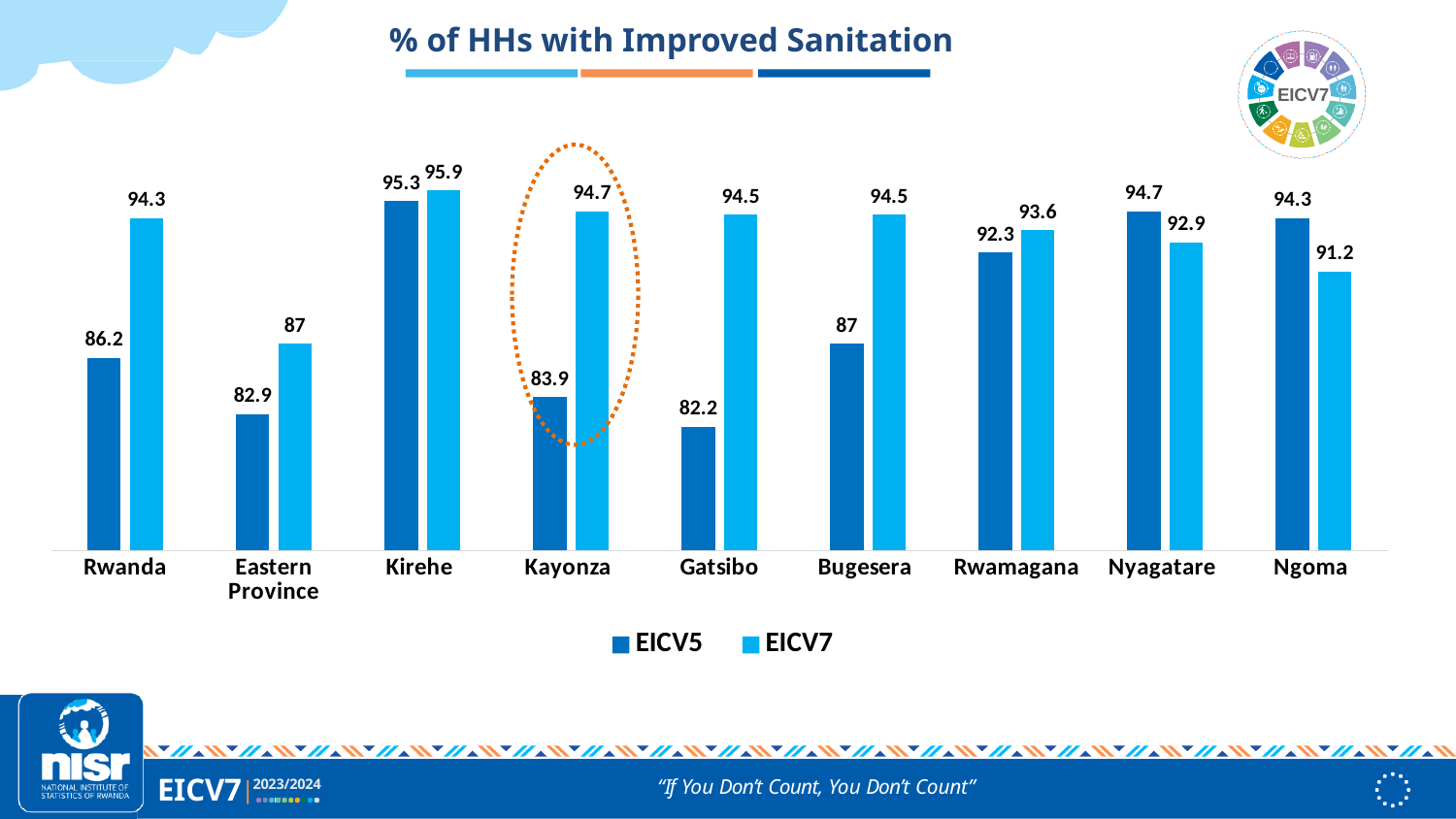
How many categories are shown on the x axis? 9 What is the EICV7 value for Kayonza? 94.7 Which district or area has the lowest EICV5 value? Gatsibo What is the difference between the EICV7 and EICV5 values for Gatsibo? 12.3 Which district or area has the highest EICV7 value? Kirehe What is the EICV7 value for Ngoma? 91.2 What is the difference between the EICV7 and EICV5 values for Kayonza? 10.8 What kind of chart is shown on the slide? Bar chart How many series does the legend list? 2 Which district or area has the lowest EICV7 value? Eastern Province For Nyagatare, which is larger: the EICV5 value or the EICV7 value? EICV5 What is the EICV5 value for Eastern Province? 82.9